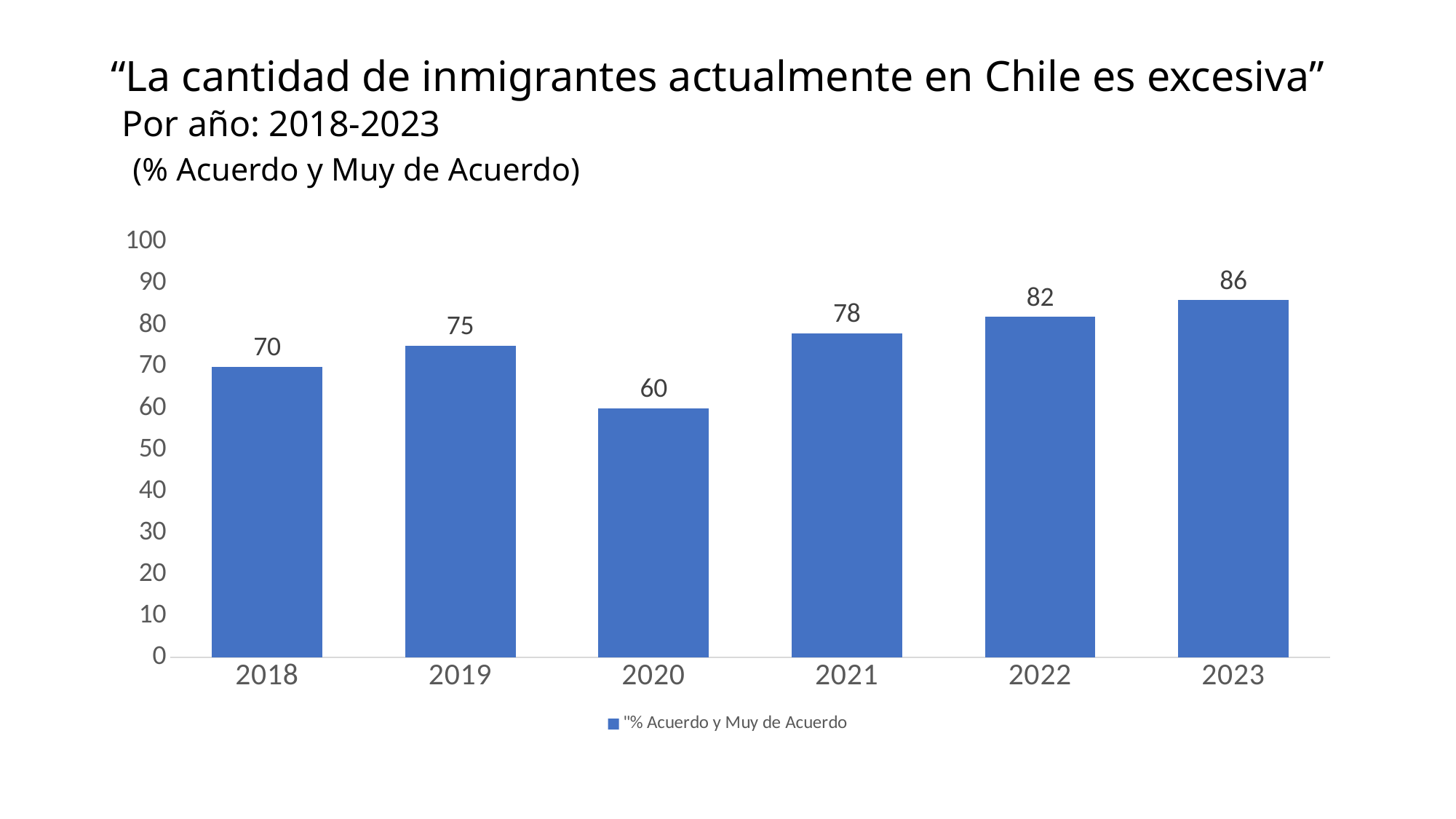
What is the value for 2023? 86 Which is larger, the value for 2019 or the value for 2022? 2022 Is the value for 2021 greater or less than 70? greater What kind of chart is this? bar chart What is the value for 2020? 60 What is the difference between the values for 2023 and 2018? 16 Which year has the highest value? 2023 Do the values rise or fall from 2020 to 2023? rise Which year has the lowest value? 2020 What is the difference between the values for 2021 and 2020? 18 What is the value for 2018? 70 How many years are shown on the x axis? 6